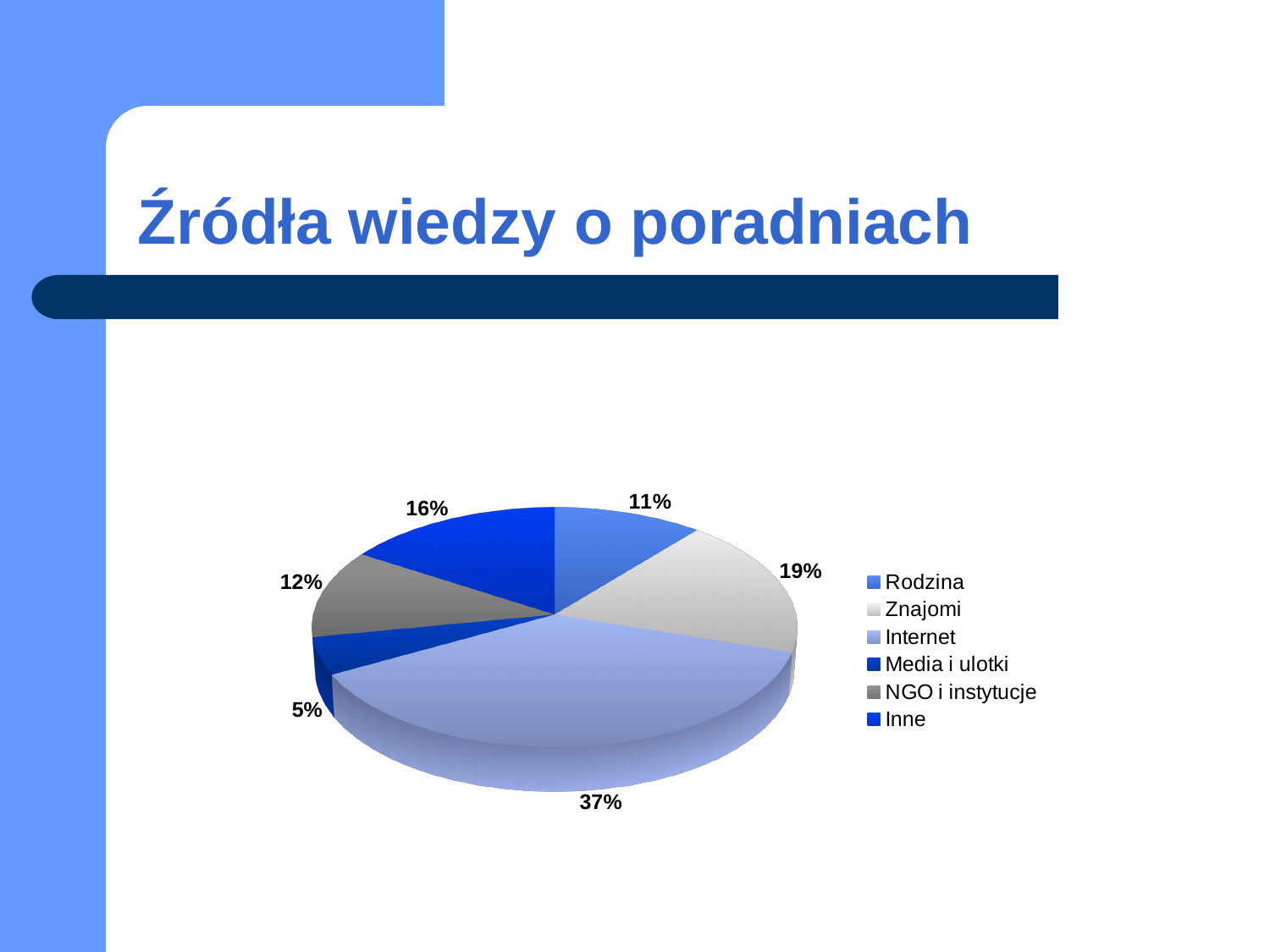
Which category has the smallest slice of the pie? Media i ulotki What percentage is shown for NGO i instytucje? 12% What percentage is shown for Znajomi? 19% What is the difference in percentage points between Internet and Znajomi? 18 What share of the pie does Internet have? 37% What is the title of the slide containing the chart? Źródła wiedzy o poradniach How many categories does the pie chart show? 6 What percentage is shown for Media i ulotki? 5% Which category has the largest slice of the pie? Internet What kind of chart is shown on the slide? Pie chart Which is larger, the share for Inne or the share for NGO i instytucje? Inne What percentage is shown for Rodzina? 11%